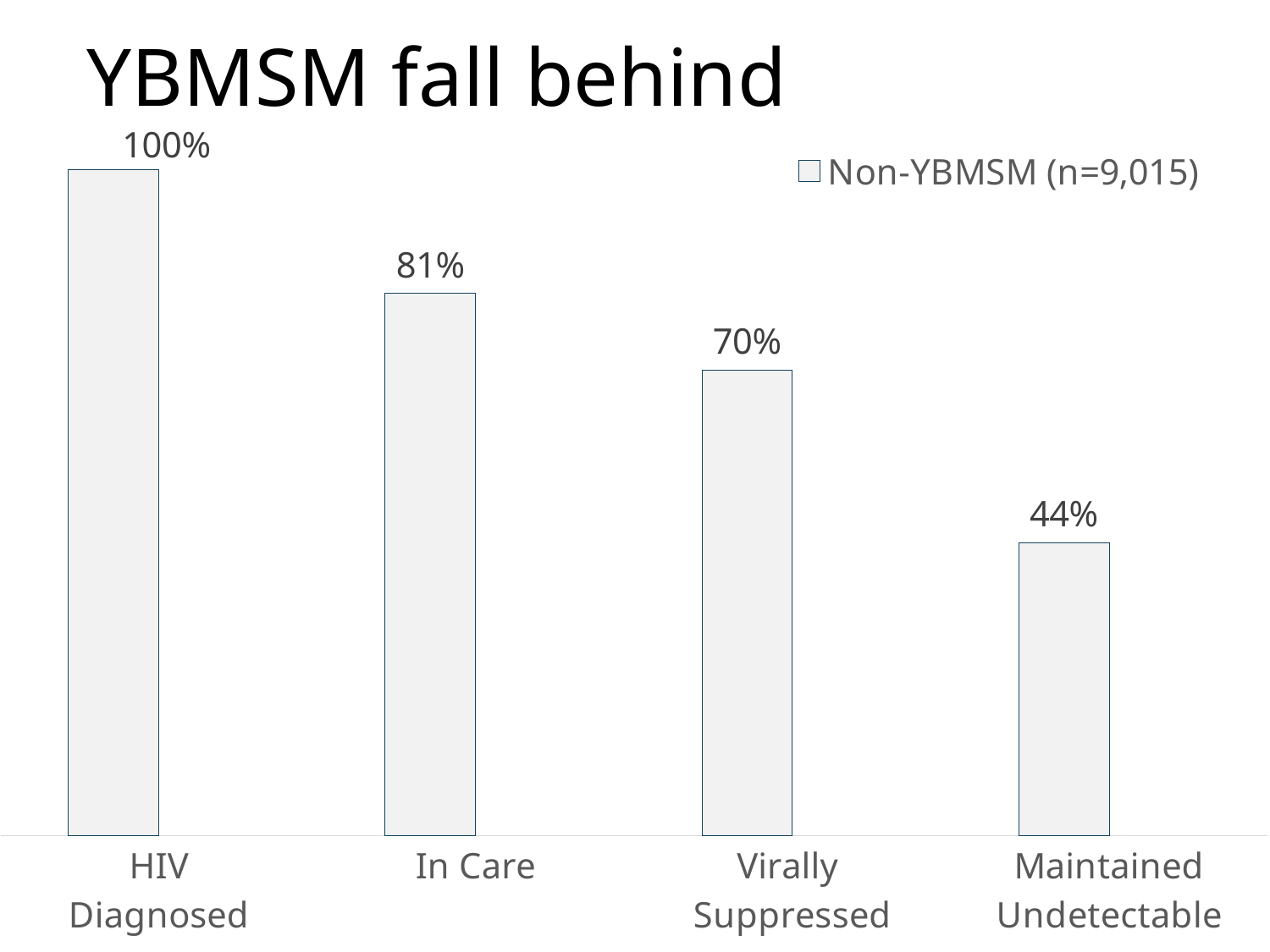
Which is larger, the value for Virally Suppressed or the value for Maintained Undetectable? Virally Suppressed What is the value for Virally Suppressed? 70% What is the difference between the values for HIV Diagnosed and Maintained Undetectable? 56% What is the value for In Care? 81% What is the value for HIV Diagnosed? 100% What is the value for Maintained Undetectable? 44% Which category has the lowest value? Maintained Undetectable What is the difference between the values for In Care and Virally Suppressed? 11% Which category has the highest value? HIV Diagnosed What kind of chart is shown on the slide? Bar chart How many categories are shown on the x axis? 4 What series does the legend list? Non-YBMSM (n=9,015)